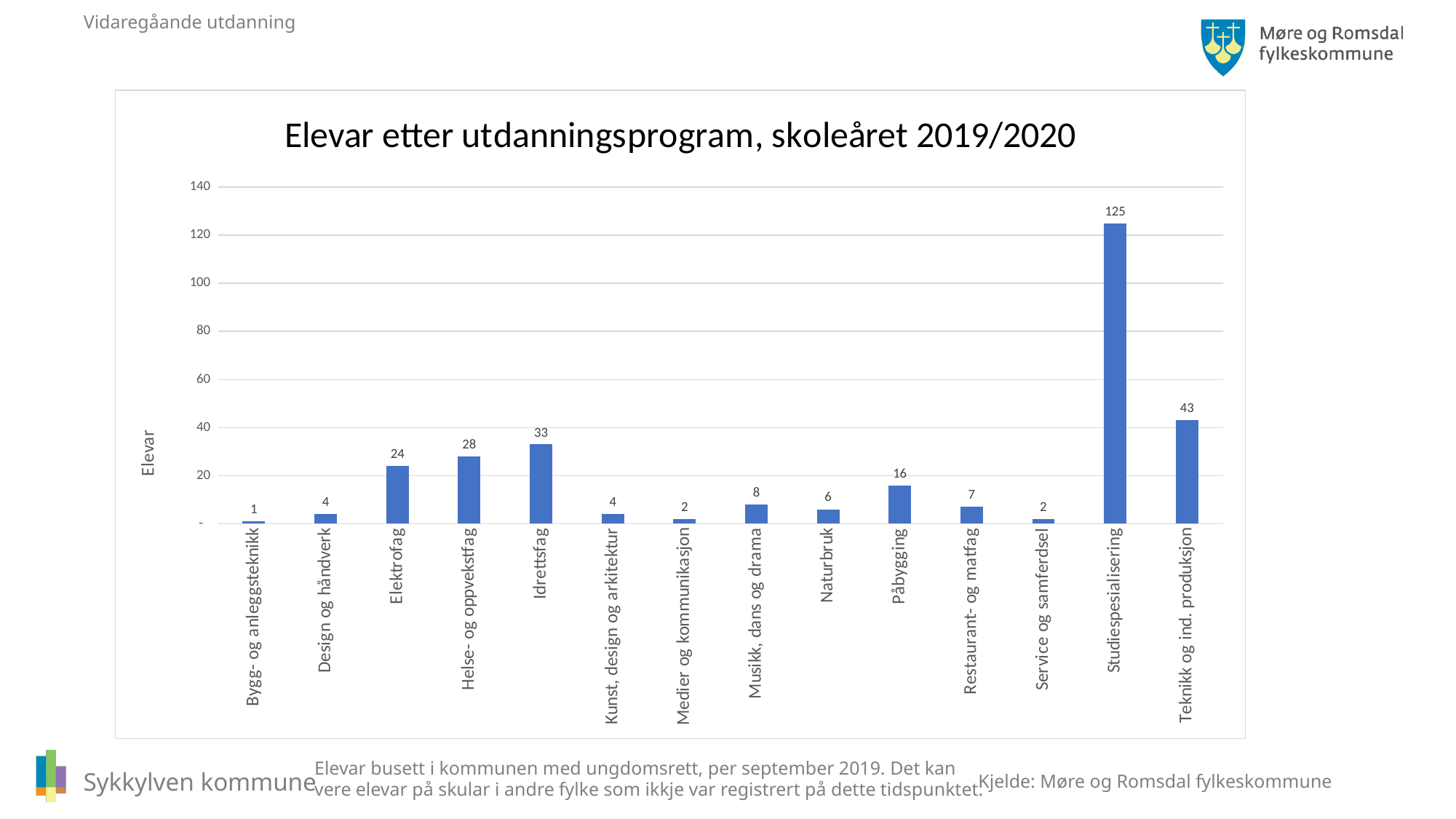
What is the difference between Idrettsfag and Elektrofag? 9 What is the difference between Studiespesialisering and Teknikk og ind. produksjon? 82 What is the value for Teknikk og ind. produksjon? 43 What is the title of the chart? Elevar etter utdanningsprogram, skoleåret 2019/2020 How many categories are shown on the x axis? 14 Which is larger, Påbygging or Musikk, dans og drama? Påbygging Which category has the highest value? Studiespesialisering Is the value for Studiespesialisering greater or less than 100? greater What is the value for Helse- og oppvekstfag? 28 What is the value for Studiespesialisering? 125 What kind of chart is this? bar chart Which category has the lowest value? Bygg- og anleggsteknikk